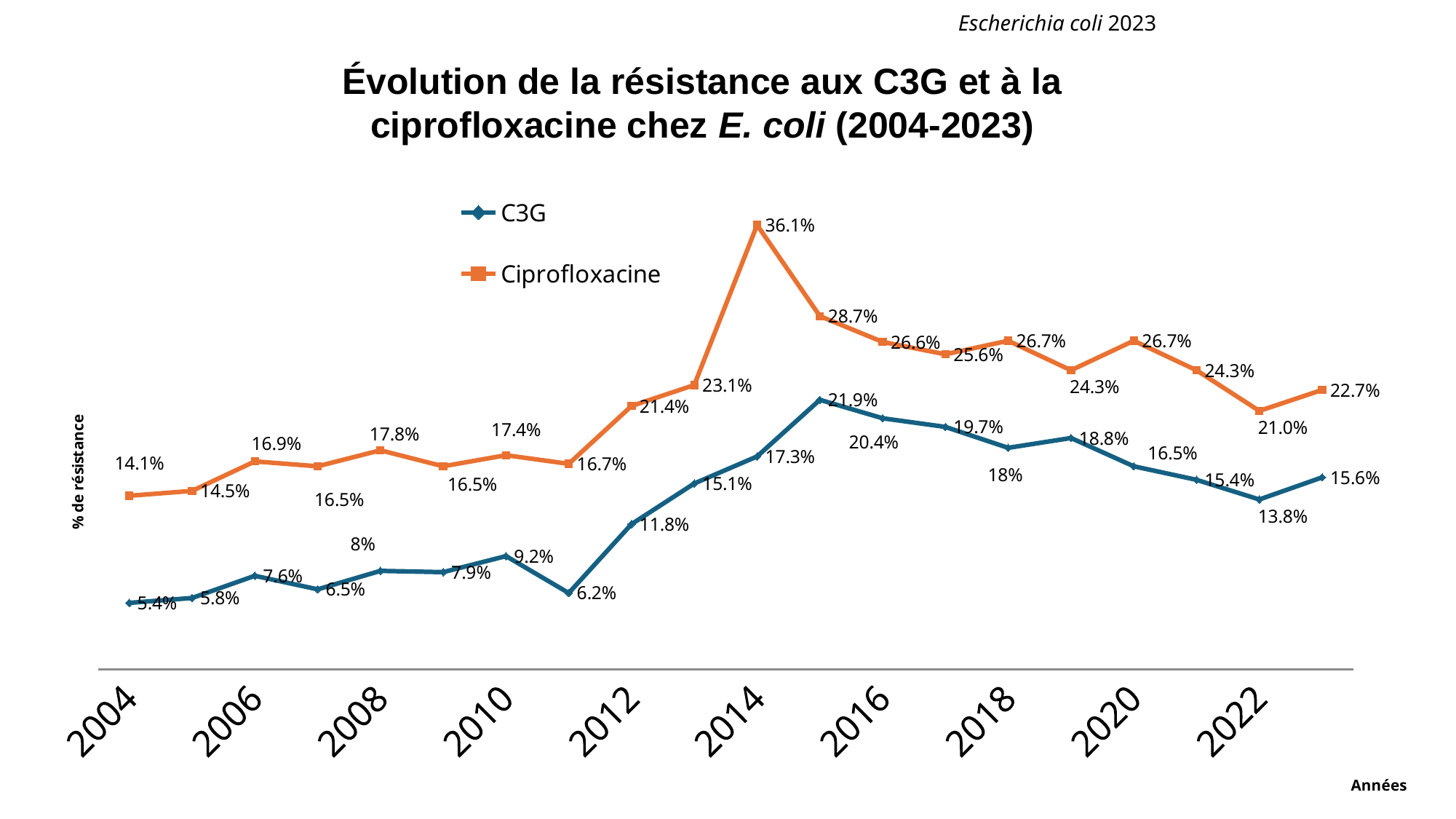
What is the Ciprofloxacine resistance value in 2014? 36.1% Which series has the higher value in 2016, C3G or Ciprofloxacine? Ciprofloxacine What is the C3G resistance value in 2004? 5.4% How many series does the legend list? 2 What is the Ciprofloxacine resistance value in 2020? 26.7% What type of chart is shown on the slide? line chart In which year does the Ciprofloxacine series reach its highest value? 2014 How many data points does each series have (2004 to 2023)? 20 What is the C3G resistance value in 2022? 13.8% Does the C3G series rise or fall between 2004 and 2014? rise What is the difference between the Ciprofloxacine and C3G values in 2012? 9.6% In which year does the C3G series have its lowest value? 2004